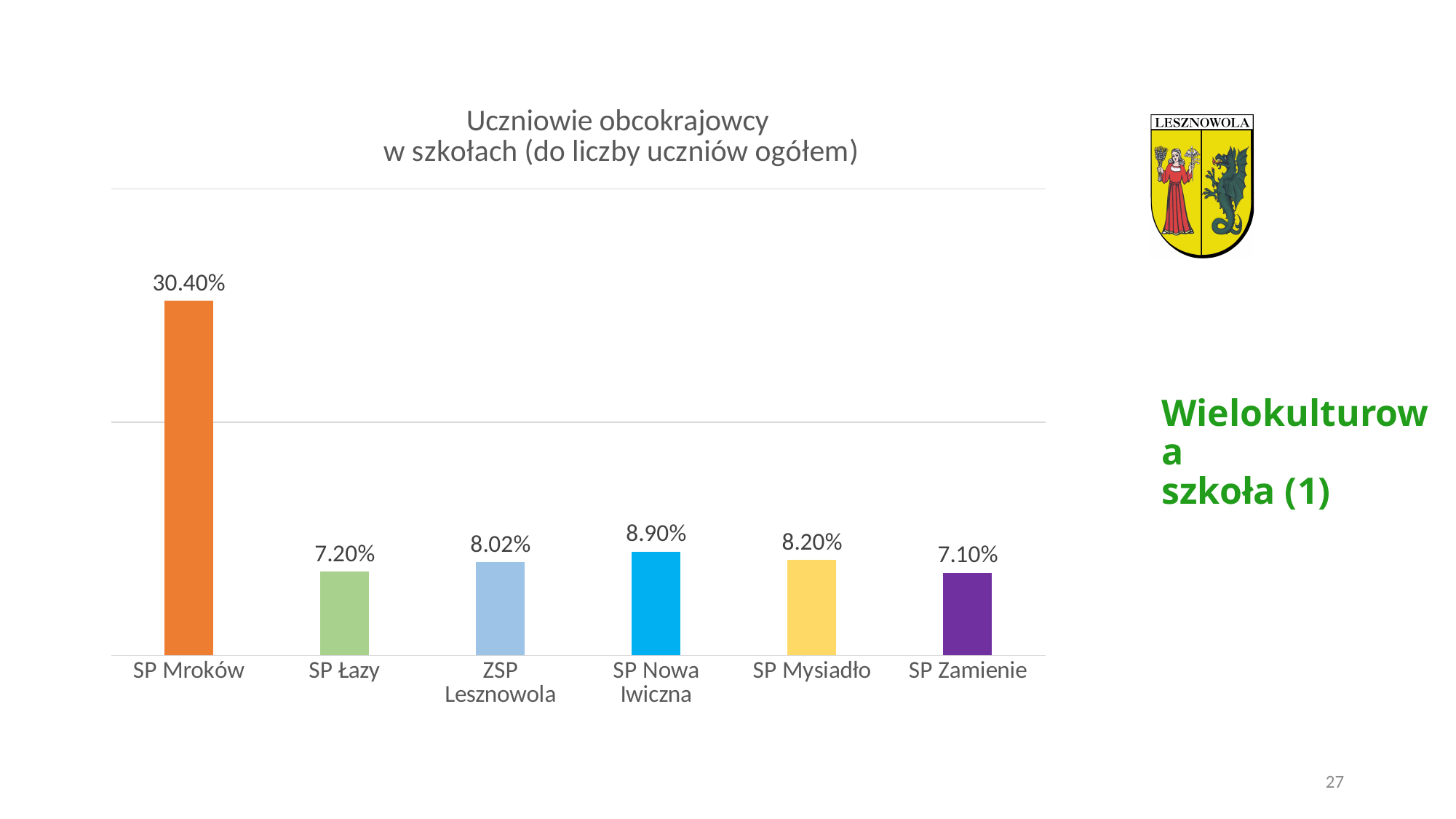
What is the value for SP Mroków? 30.40% Which school has the lowest share of foreign students? SP Zamienie What is the difference between the values for SP Nowa Iwiczna and SP Mysiadło? 0.70% Which school has the highest share of foreign students? SP Mroków What is the difference between the values for SP Mroków and SP Łazy? 23.20% What is the value for SP Zamienie? 7.10% What is the value for SP Nowa Iwiczna? 8.90% What is the value for ZSP Lesznowola? 8.02% What is the title of the chart? Uczniowie obcokrajowcy w szkołach (do liczby uczniów ogółem) Which is larger, the value for SP Mysiadło or the value for SP Łazy? SP Mysiadło How many schools are shown in the chart? 6 What kind of chart is shown on the slide? Bar chart